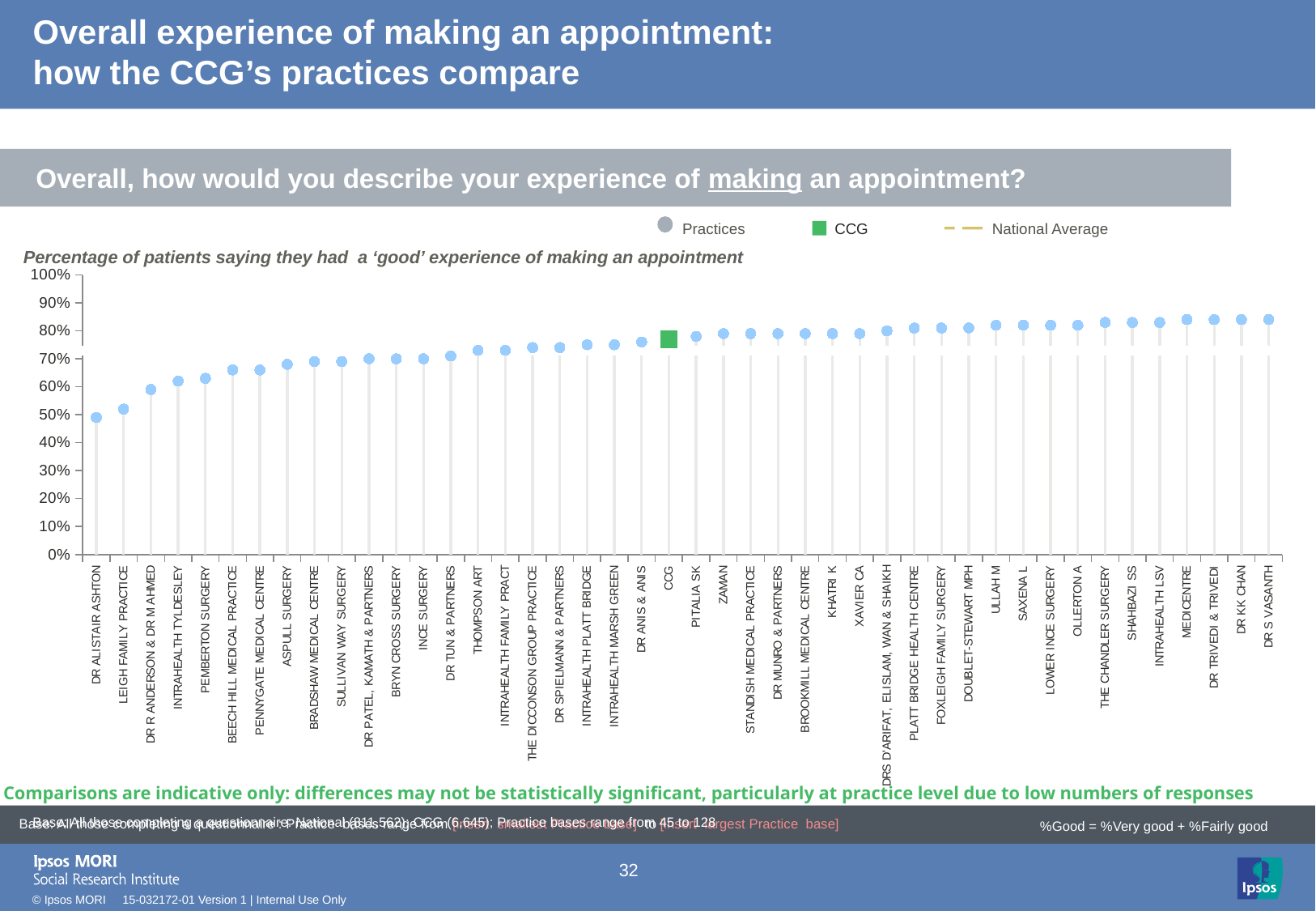
Is the value for PEMBERTON SURGERY greater or less than 60%? greater Which has the higher value, LEIGH FAMILY PRACTICE or INCE SURGERY? INCE SURGERY Which practice has the lowest percentage of patients saying they had a 'good' experience of making an appointment? DR ALISTAIR ASHTON How many entries does the legend list? 3 What kind of chart is shown on the slide? Scatter (dot) chart What colour is the CCG marker in the chart? Green Do the values rise or fall moving from left to right along the x axis? rise Is the value for the CCG greater or less than 70%? greater Which has the higher value, DR ALISTAIR ASHTON or DR S VASANTH? DR S VASANTH Is the value for DR S VASANTH greater or less than 80%? greater